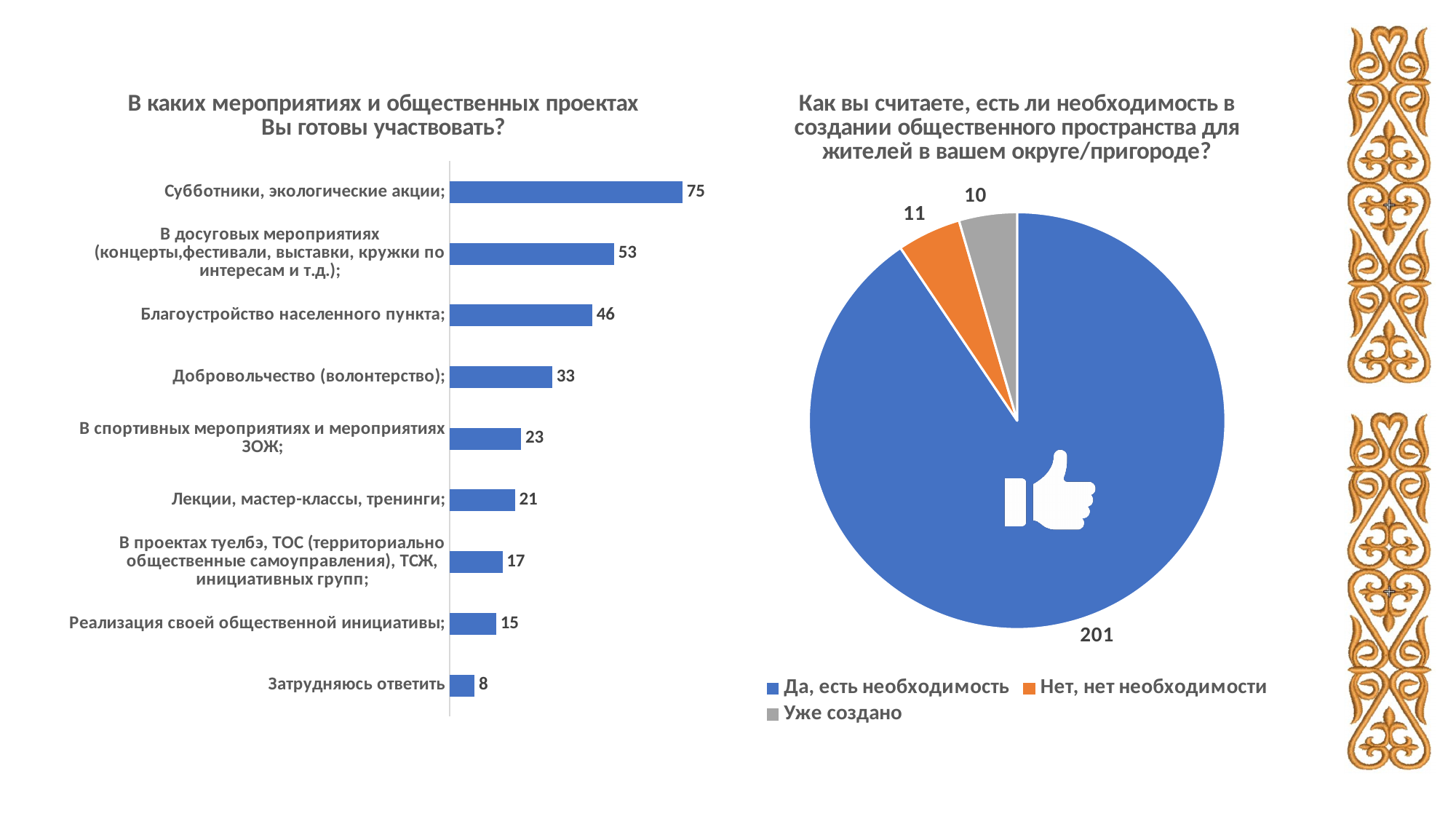
How many categories are shown in the left bar chart 'В каких мероприятиях и общественных проектах Вы готовы участвовать?'? 9 What type of chart is the left chart 'В каких мероприятиях и общественных проектах Вы готовы участвовать?'? Bar chart In the left chart 'В каких мероприятиях и общественных проектах Вы готовы участвовать?', which category has the lowest value? Затрудняюсь ответить In the left chart 'В каких мероприятиях и общественных проектах Вы готовы участвовать?', which is larger: 'Лекции, мастер-классы, тренинги' or 'Реализация своей общественной инициативы'? Лекции, мастер-классы, тренинги In the right pie chart 'Как вы считаете, есть ли необходимость в создании общественного пространства для жителей в вашем округе/пригороде?', what is the value for 'Уже создано'? 10 In the left chart 'В каких мероприятиях и общественных проектах Вы готовы участвовать?', what is the difference between 'Субботники, экологические акции' and 'Благоустройство населенного пункта'? 29 In the left chart 'В каких мероприятиях и общественных проектах Вы готовы участвовать?', what is the value for 'Субботники, экологические акции'? 75 In the right pie chart, which colour represents 'Нет, нет необходимости'? Orange How many entries does the legend of the right pie chart list? 3 In the left chart 'В каких мероприятиях и общественных проектах Вы готовы участвовать?', which category has the highest value? Субботники, экологические акции In the left chart 'В каких мероприятиях и общественных проектах Вы готовы участвовать?', what is the value for 'Добровольчество (волонтерство)'? 33 In the right pie chart 'Как вы считаете, есть ли необходимость в создании общественного пространства для жителей в вашем округе/пригороде?', what is the value for 'Да, есть необходимость'? 201